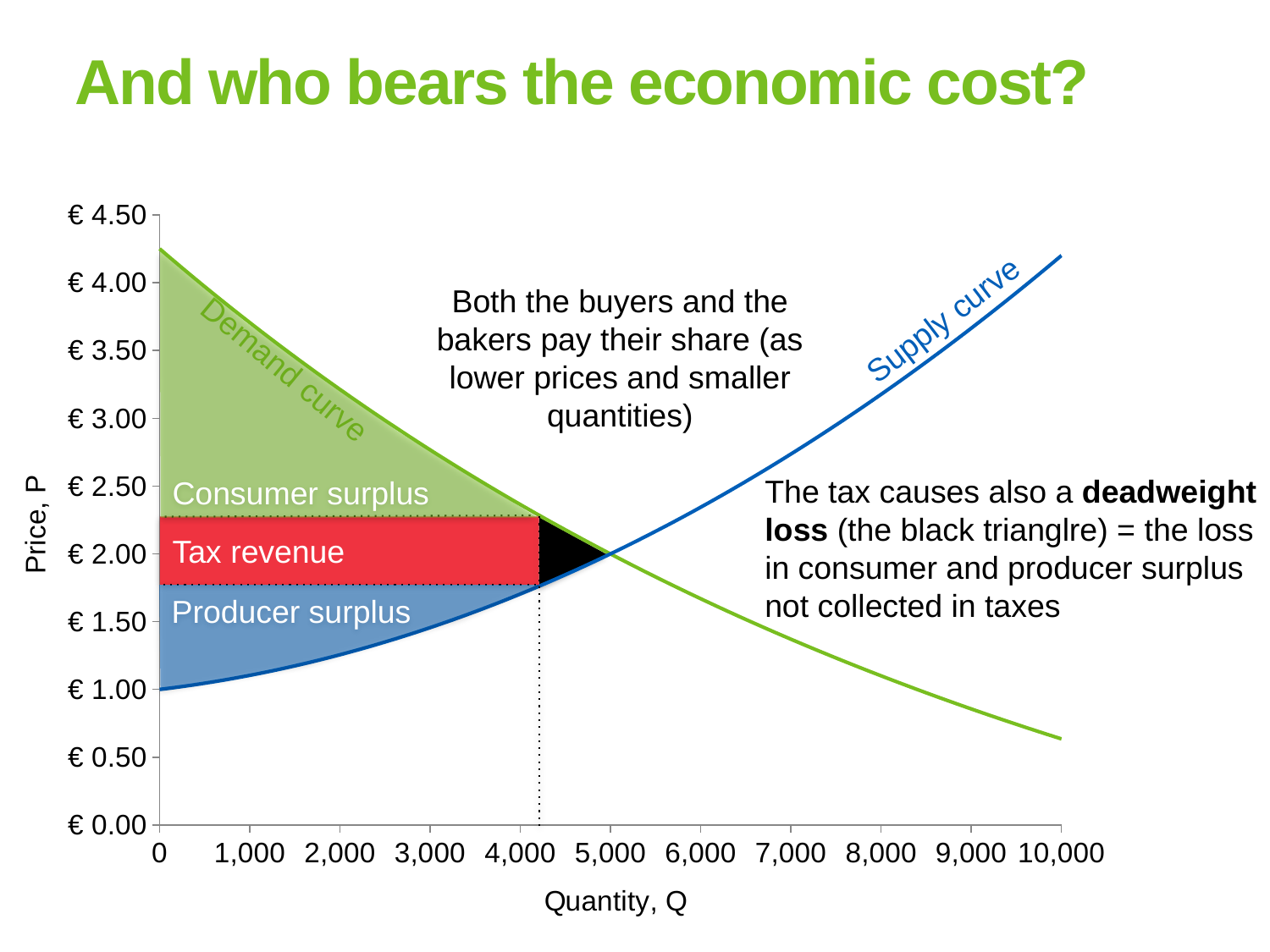
At quantity 0, which curve shows the higher price, the demand curve or the supply curve? Demand curve At quantity 10,000, which curve shows the higher price, the demand curve or the supply curve? Supply curve What kind of chart is shown on the slide? line chart How many curves are plotted on the chart? 2 Is the price on the supply curve at quantity 10,000 greater or less than € 4.00? greater Which shaded area on the chart is coloured red? Tax revenue Is the price on the demand curve at quantity 0 greater or less than € 4.00? greater What is the label of the y axis? Price, P Is the price on the demand curve at quantity 10,000 greater or less than € 1.00? less Does the demand curve rise or fall as quantity increases along the x axis? fall Does the supply curve rise or fall as quantity increases along the x axis? rise